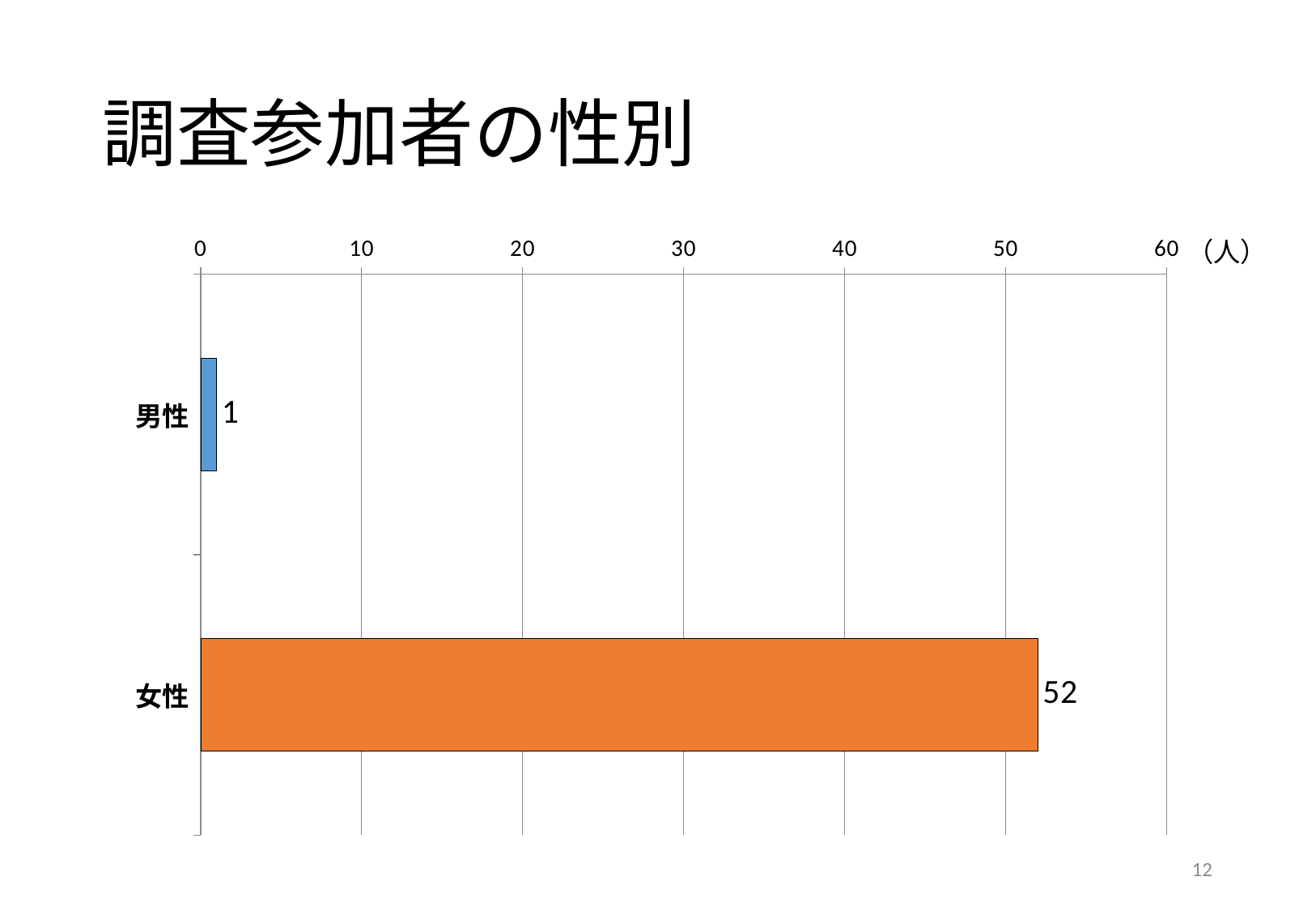
Which category has the highest value? 女性 What is the difference between the values for 女性 and 男性? 51 Which is larger, the value for 男性 or the value for 女性? 女性 What is the value for 男性? 1 What kind of chart is shown on the slide? bar chart How many categories are shown in the chart? 2 Is the value for 男性 greater or less than 10? less What is the value for 女性? 52 What is the title of the slide? 調査参加者の性別 What unit is shown at the end of the value axis? （人） Which category has the lowest value? 男性 Is the value for 女性 greater or less than 50? greater